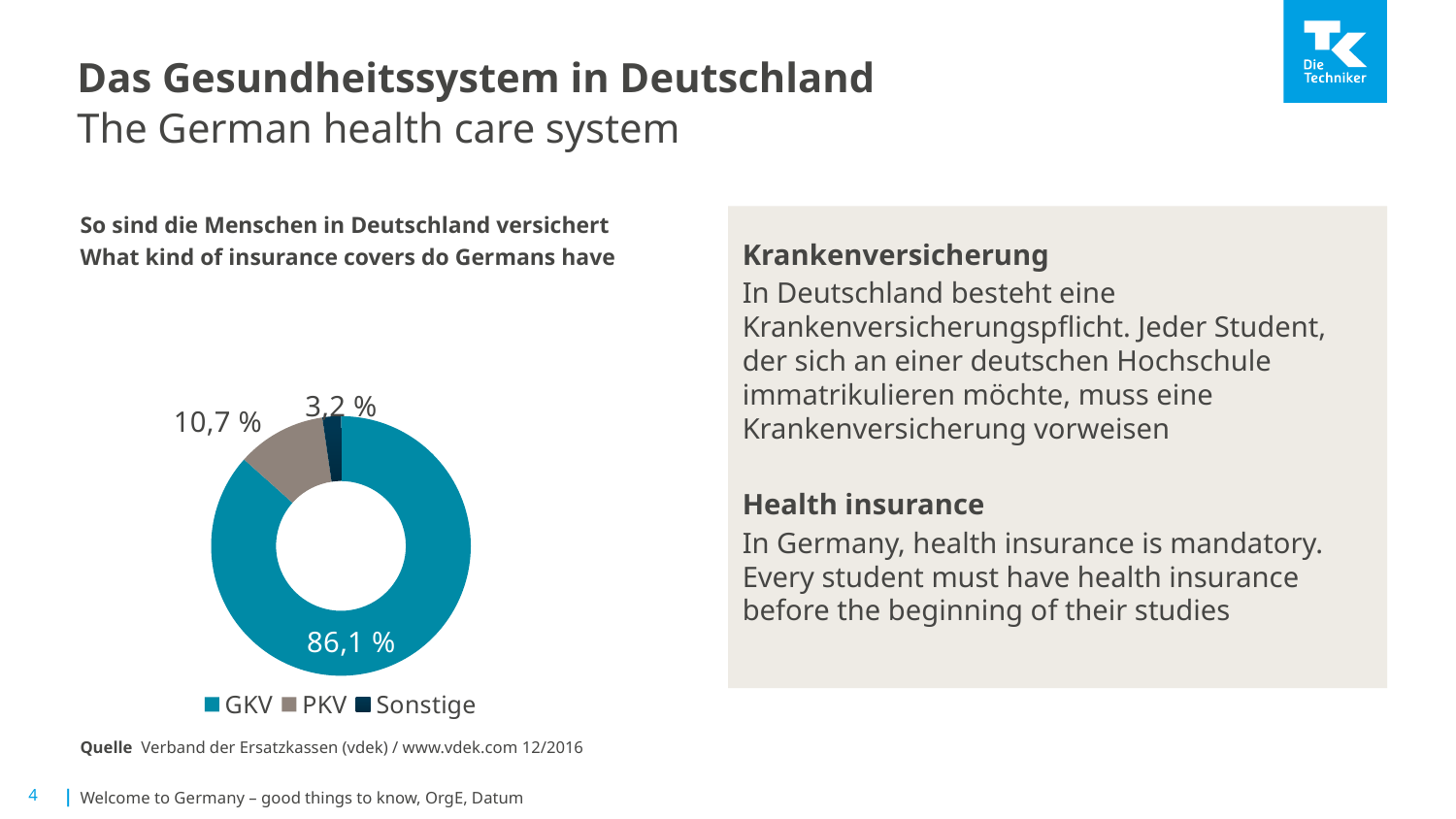
What share of the chart does PKV have? 10,7 % What colour is the GKV slice in the chart? Teal (blue-green) Which category has the largest share of the chart? GKV What is the difference between the shares for GKV and PKV? 75,4 % What share of the chart does GKV have? 86,1 % Which is larger, the share for PKV or the share for Sonstige? PKV What is the difference between the shares for PKV and Sonstige? 7,5 % Which category has the smallest share of the chart? Sonstige What kind of chart is shown on the slide? Pie chart (doughnut) How many entries does the legend list? 3 What share of the chart does Sonstige have? 3,2 % How many categories does the chart show? 3